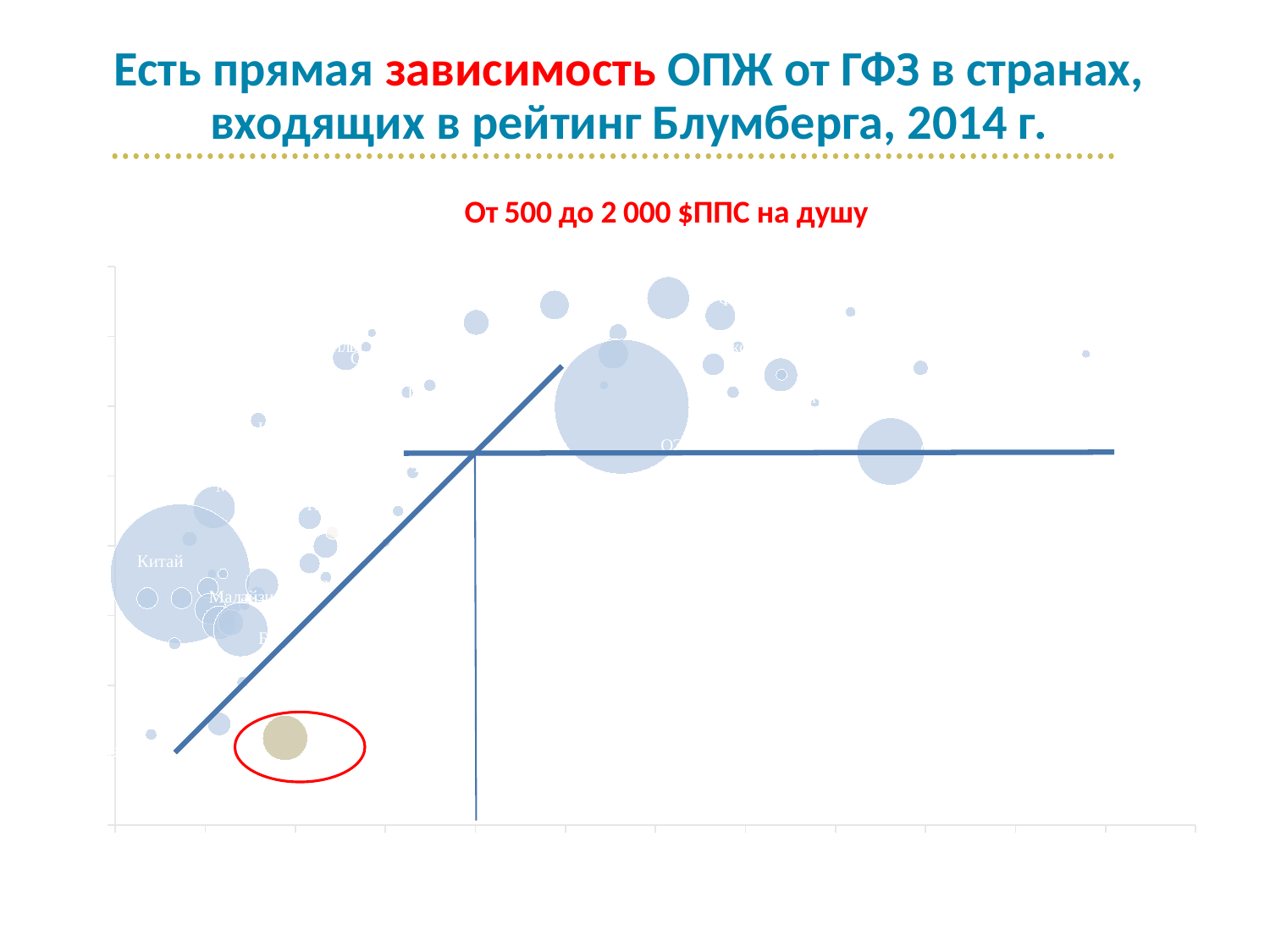
What kind of chart is shown on the slide? Bubble chart What colour is the ellipse drawn around the highlighted bubble near the bottom left of the chart? Red According to the drawn trend line, do the values rise or stay flat to the right of the vertical line? Stay flat Which country is labelled on the large bubble at the left of the chart? Китай According to the drawn trend line, do the values rise or fall from the bottom left up to the vertical line? Rise